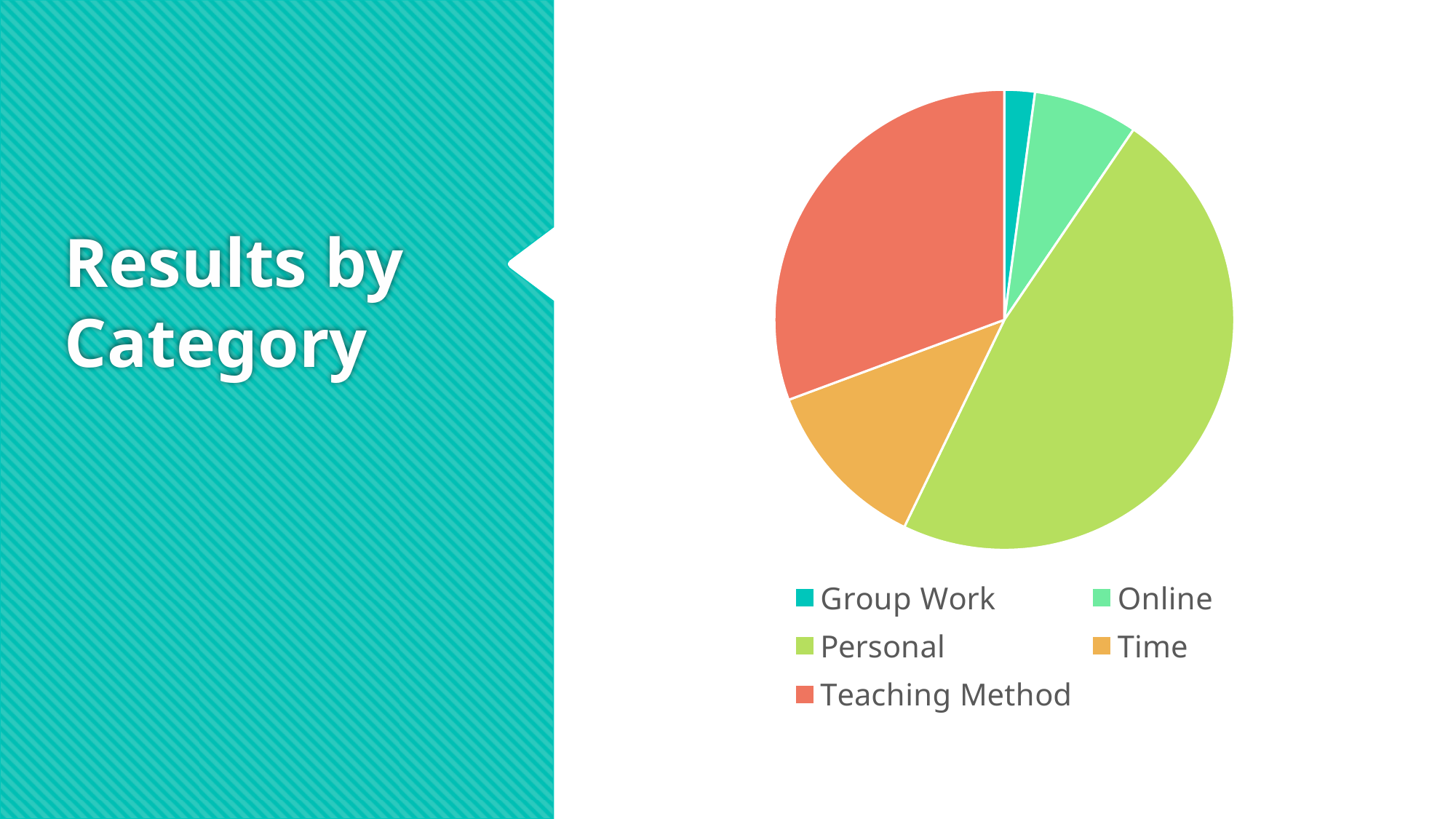
Which slice is larger, Teaching Method or Time? Teaching Method Which category has the largest slice of the pie chart? Personal Which slice is larger, Time or Online? Time What is the title shown on the slide next to the pie chart? Results by Category Which slice is larger, Personal or Teaching Method? Personal How many categories does the pie chart show? 5 What colour is the Personal slice in the pie chart? green What kind of chart is shown on the slide? pie chart Which category has the smallest slice of the pie chart? Group Work Which category has the second-largest slice of the pie chart? Teaching Method